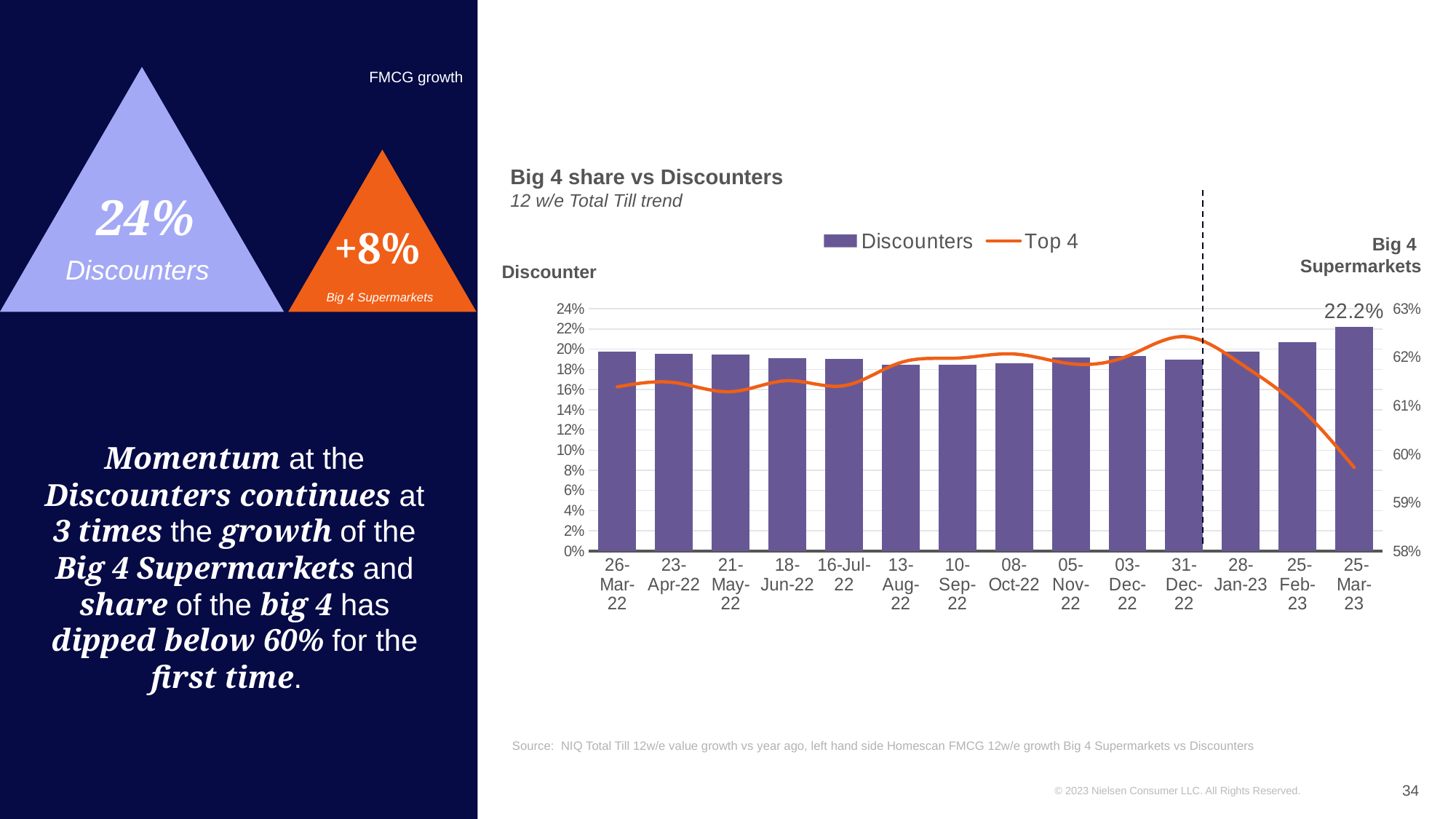
In the 'Big 4 share vs Discounters' chart, which period has the highest Discounters bar? 25-Mar-23 In the 'Big 4 share vs Discounters' chart, which series is drawn as a line rather than bars? Top 4 What kind of chart is 'Big 4 share vs Discounters'? A combined bar and line chart In the 'Big 4 share vs Discounters' chart, which is larger: the Discounters bar for 25-Mar-23 or for 26-Mar-22? 25-Mar-23 In the 'Big 4 share vs Discounters' chart, at which period is the Top 4 line at its lowest? 25-Mar-23 In the 'Big 4 share vs Discounters' chart, at which period does the Top 4 line reach its highest point? 31-Dec-22 How many series does the legend of the 'Big 4 share vs Discounters' chart list? 2 How many time periods are shown on the x axis of the 'Big 4 share vs Discounters' chart? 14 In the 'Big 4 share vs Discounters' chart, does the Top 4 line rise or fall from 31-Dec-22 to 25-Mar-23? It falls In the 'Big 4 share vs Discounters' chart, is the Discounters value for 26-Mar-22 greater or less than 18%? greater What is the Discounters value for 25-Mar-23 in the 'Big 4 share vs Discounters' chart? 22.2% In the 'Big 4 share vs Discounters' chart, is the Top 4 value for 25-Mar-23 greater or less than 60%? less